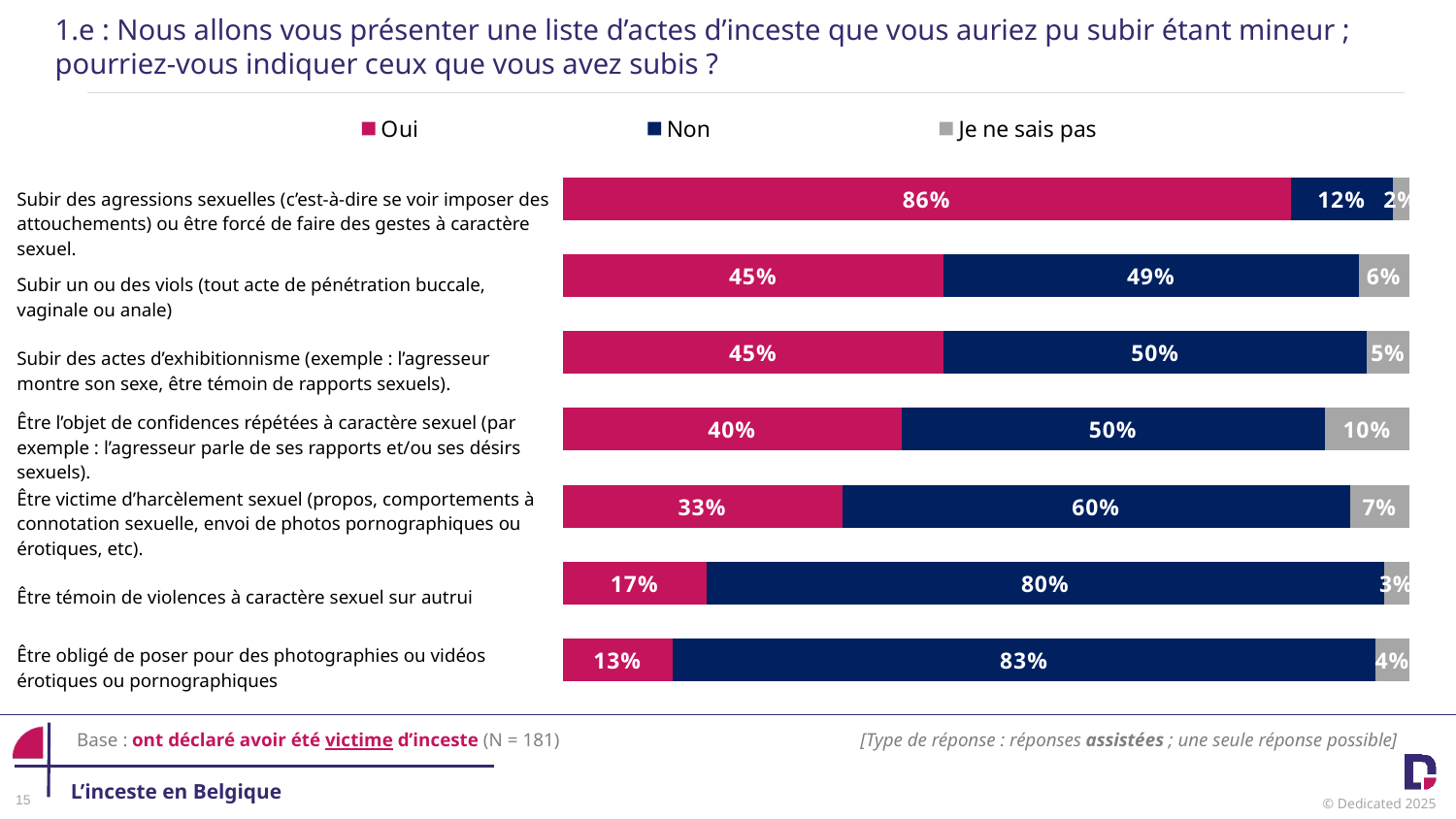
What percentage answered "Je ne sais pas" for "Être l'objet de confidences répétées à caractère sexuel"? 10% Which category has the lowest "Oui" percentage? Être obligé de poser pour des photographies ou vidéos érotiques ou pornographiques How many categories (acts) are shown in the chart? 7 What percentage answered "Non" for "Être victime d'harcèlement sexuel"? 60% Which category has the highest "Oui" percentage? Subir des agressions sexuelles Which series is shown in dark blue in the legend? Non Which is larger: the "Oui" percentage for "Être victime d'harcèlement sexuel" or for "Être témoin de violences à caractère sexuel sur autrui"? Être victime d'harcèlement sexuel What kind of chart is shown on the slide? Stacked bar chart What is the difference between the "Non" percentages for "Être témoin de violences à caractère sexuel sur autrui" and "Subir un ou des viols"? 31% How many series does the legend list? 3 What percentage answered "Oui" for "Subir des agressions sexuelles"? 86% What is the total of the "Oui" and "Non" percentages for "Subir des actes d'exhibitionnisme"? 95%